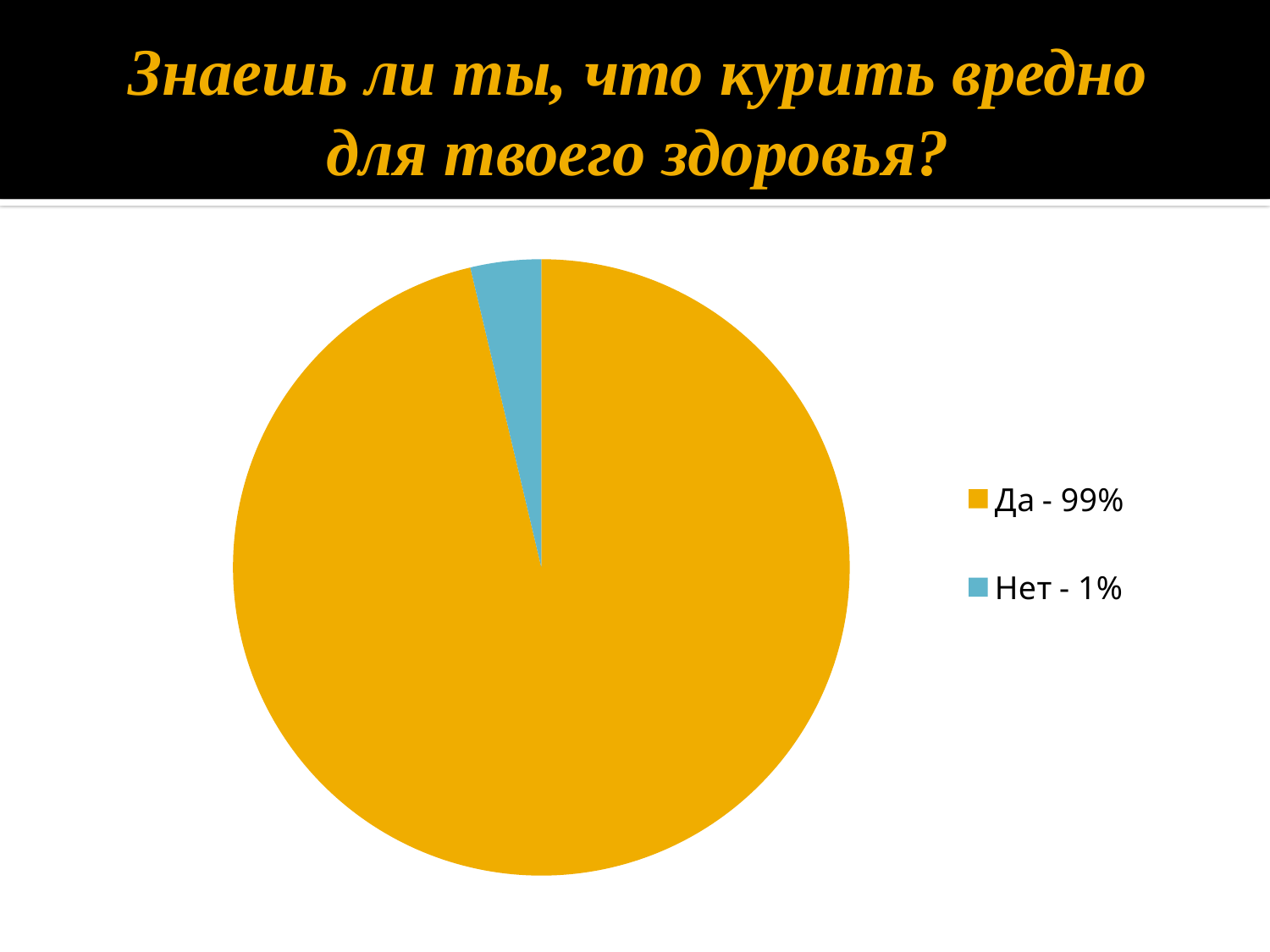
Which answer has the largest share of the pie? Да How many entries does the legend list? 2 How many slices does the pie chart have? 2 What is the title of the slide above the chart? Знаешь ли ты, что курить вредно для твоего здоровья? What is the difference in percentage points between "Да" and "Нет"? 98 What share of the pie does the "Нет" slice represent? 1% Which answer has the smallest share of the pie? Нет Which is larger, the share for "Да" or the share for "Нет"? Да What kind of chart is shown on the slide? pie chart What colour is the "Да" slice of the pie? yellow-orange What percentage is shown for "Да" in the legend? 99% What percentage is shown for "Нет" in the legend? 1%